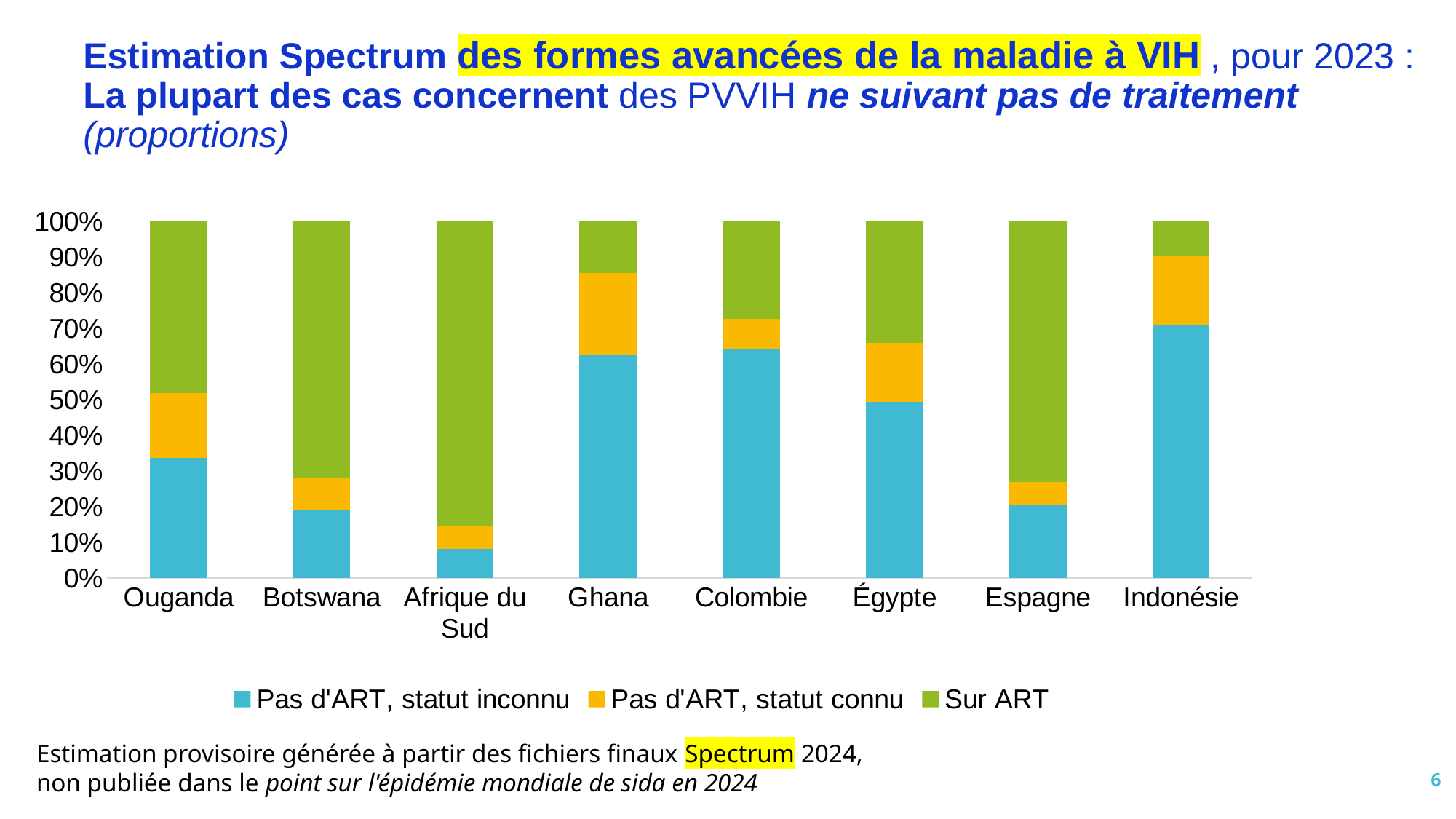
Is the 'Pas d'ART, statut inconnu' share for Espagne greater or less than 30%? less How many series does the chart legend list? 3 How many countries are shown on the x axis of the chart? 8 Which legend entry is shown in green? Sur ART Which has a larger 'Pas d'ART, statut inconnu' share, Colombie or Égypte? Colombie Which country has the largest share of 'Pas d'ART, statut inconnu'? Indonésie What is the total of the stacked bar for Ghana? 100% Which country has the largest share of 'Sur ART'? Afrique du Sud Is the 'Pas d'ART, statut inconnu' share for Ouganda greater or less than 30%? greater Is the 'Pas d'ART, statut inconnu' share for Ghana greater or less than 60%? greater What kind of chart is shown on the slide? Stacked bar chart Which country has the smallest share of 'Pas d'ART, statut inconnu'? Afrique du Sud